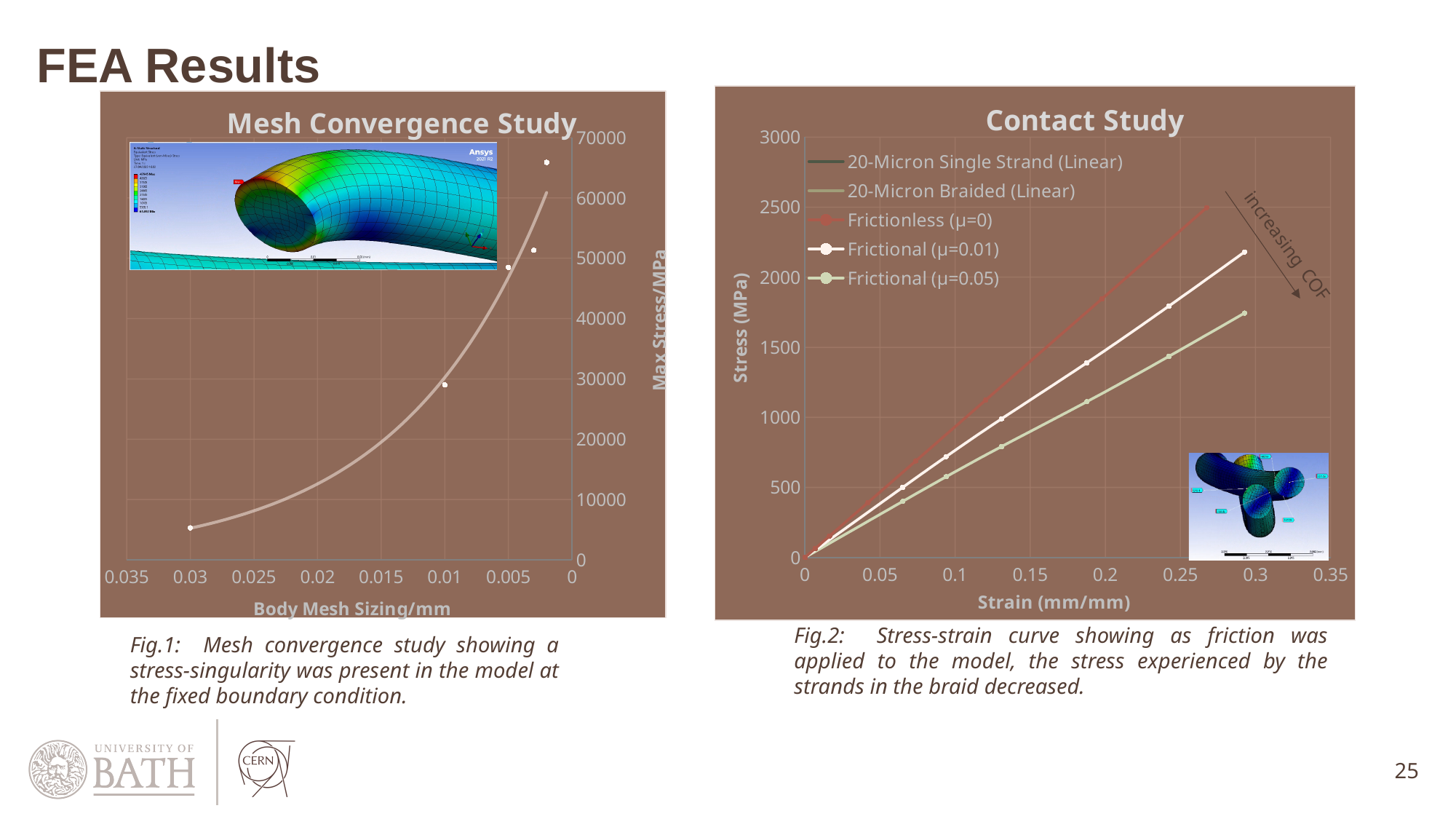
What is the title of the chart on the left of the slide? Mesh Convergence Study In the Mesh Convergence Study chart, is the highest plotted max stress value greater or less than 60000? greater In the Contact Study chart, how many series does the legend list? 5 In the Contact Study chart, which series has the lowest stress at a strain of 0.25? Frictional (μ=0.05) In the Mesh Convergence Study chart, is the max stress at a body mesh sizing of 0.03 greater or less than 10000? less What kind of chart is the Contact Study chart? Line chart What is the y-axis title of the Mesh Convergence Study chart? Max Stress/MPa In the Contact Study chart, is the stress for Frictional (μ=0.01) at its final point greater or less than 2000? greater In the Contact Study chart, at a strain of 0.2, which series has the larger stress: Frictional (μ=0.01) or Frictional (μ=0.05)? Frictional (μ=0.01) In the Contact Study chart, does stress rise or fall as strain increases? Rises